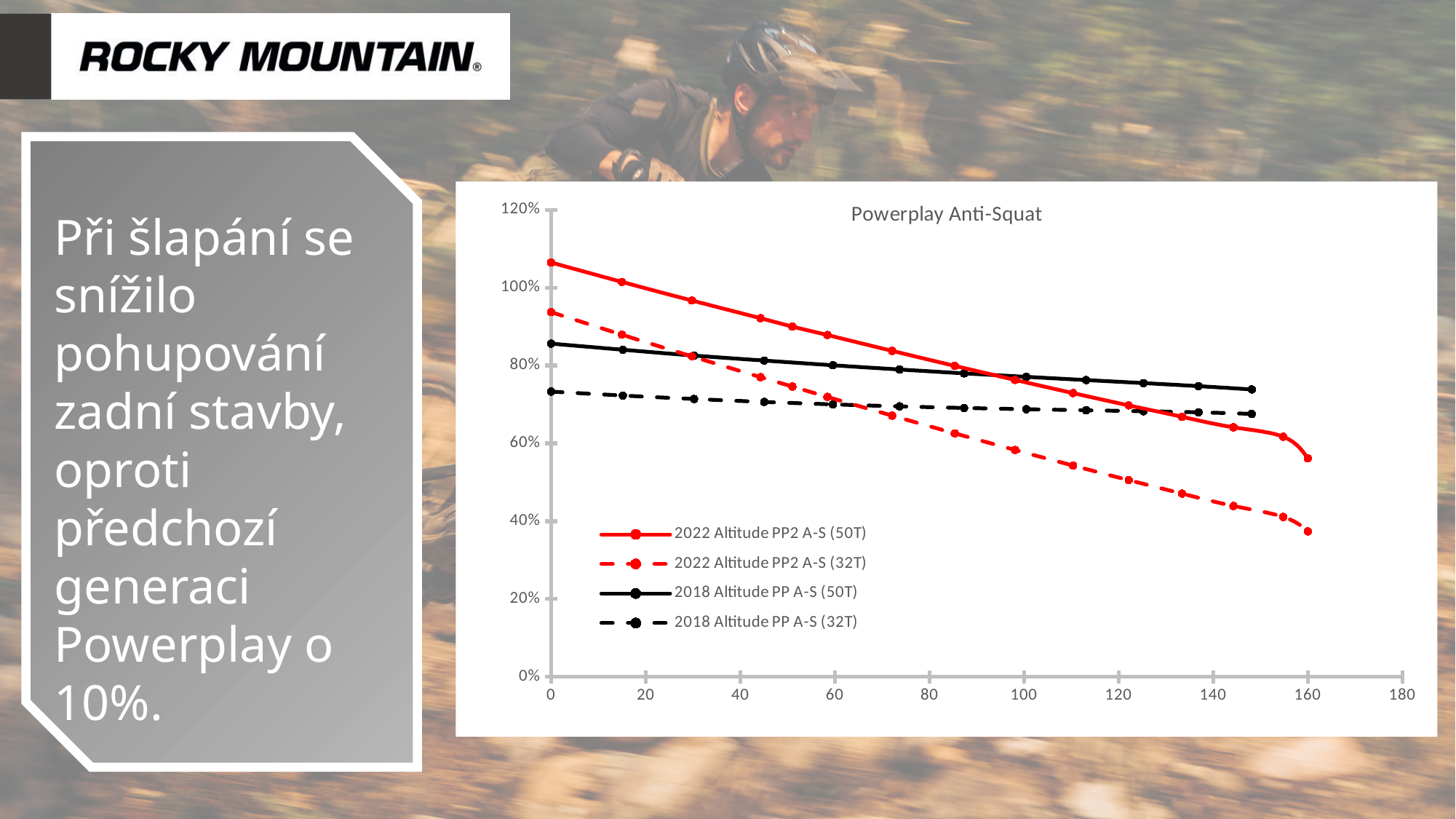
How many series does the chart legend list? 4 Is the value of the 2022 Altitude PP2 A-S (50T) series at x = 0 greater or less than 100%? greater Do the values of the 2022 Altitude PP2 A-S (50T) series rise or fall as x increases? fall Is the value of the 2018 Altitude PP A-S (50T) series at x = 0 greater or less than 80%? greater Which series has the lowest value at x = 0? 2018 Altitude PP A-S (32T) Which series has the highest value at x = 0? 2022 Altitude PP2 A-S (50T) At x = 140, which is higher: 2022 Altitude PP2 A-S (50T) or 2018 Altitude PP A-S (50T)? 2018 Altitude PP A-S (50T) What is the title of the chart? Powerplay Anti-Squat At x = 0, which is higher: 2022 Altitude PP2 A-S (32T) or 2018 Altitude PP A-S (32T)? 2022 Altitude PP2 A-S (32T) Is the value of the 2022 Altitude PP2 A-S (32T) series at x = 160 greater or less than 40%? less What colour are the lines for the 2018 Altitude PP A-S series? black What kind of chart is shown on the slide? line chart